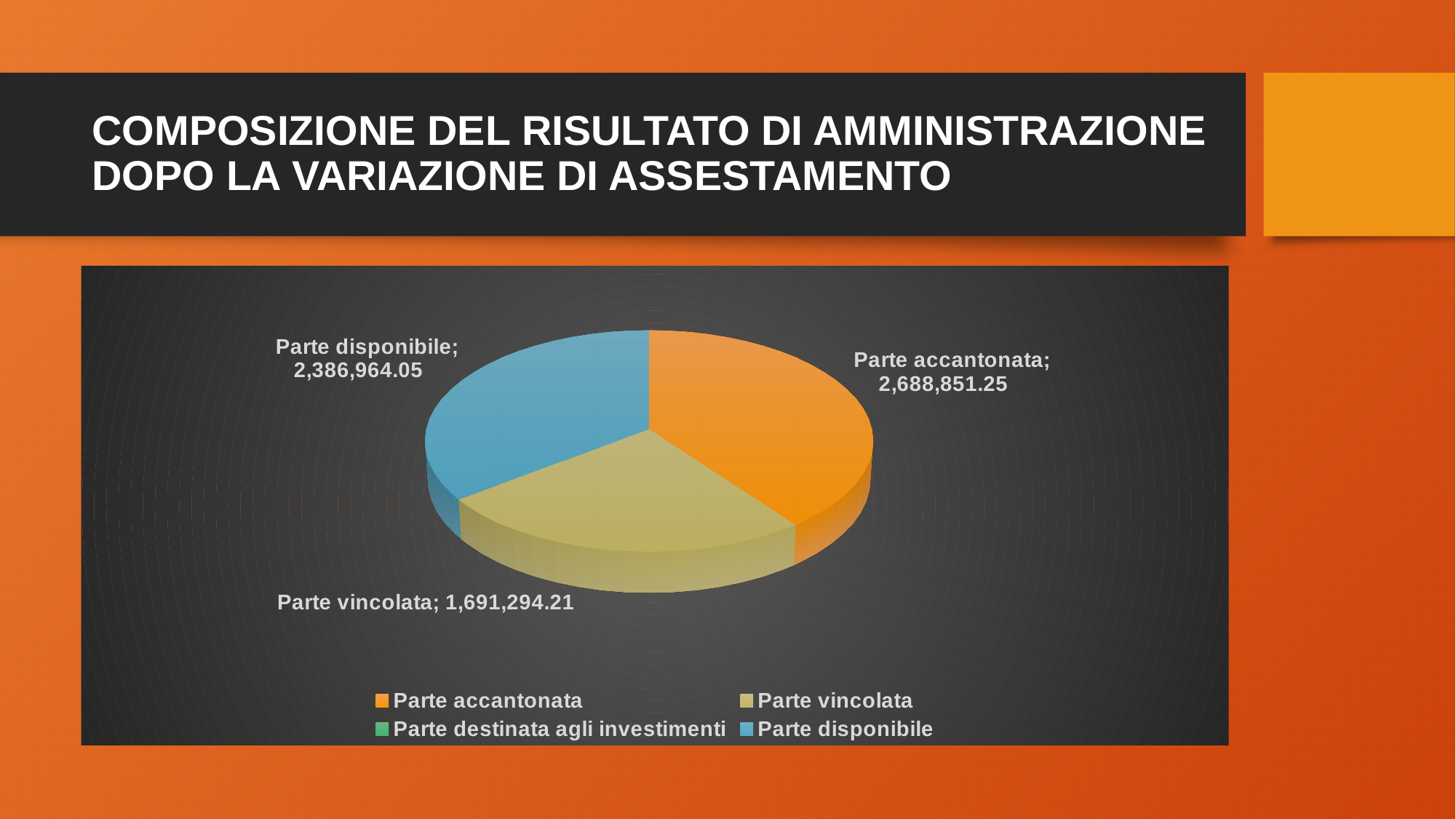
What is the value for Parte vincolata? 1,691,294.21 Which is larger, Parte disponibile or Parte vincolata? Parte disponibile How many slices with data labels are shown in the pie chart? 3 Which category has the largest slice of the pie? Parte accantonata What is the difference between the values for Parte disponibile and Parte vincolata? 695,669.84 What type of chart is shown on the slide? pie chart What is the difference between the values for Parte accantonata and Parte disponibile? 301,887.20 Which legend entry has no visible slice in the pie? Parte destinata agli investimenti What is the value for Parte disponibile? 2,386,964.05 Which labelled category has the smallest slice of the pie? Parte vincolata What is the value for Parte accantonata? 2,688,851.25 How many entries does the legend list? 4